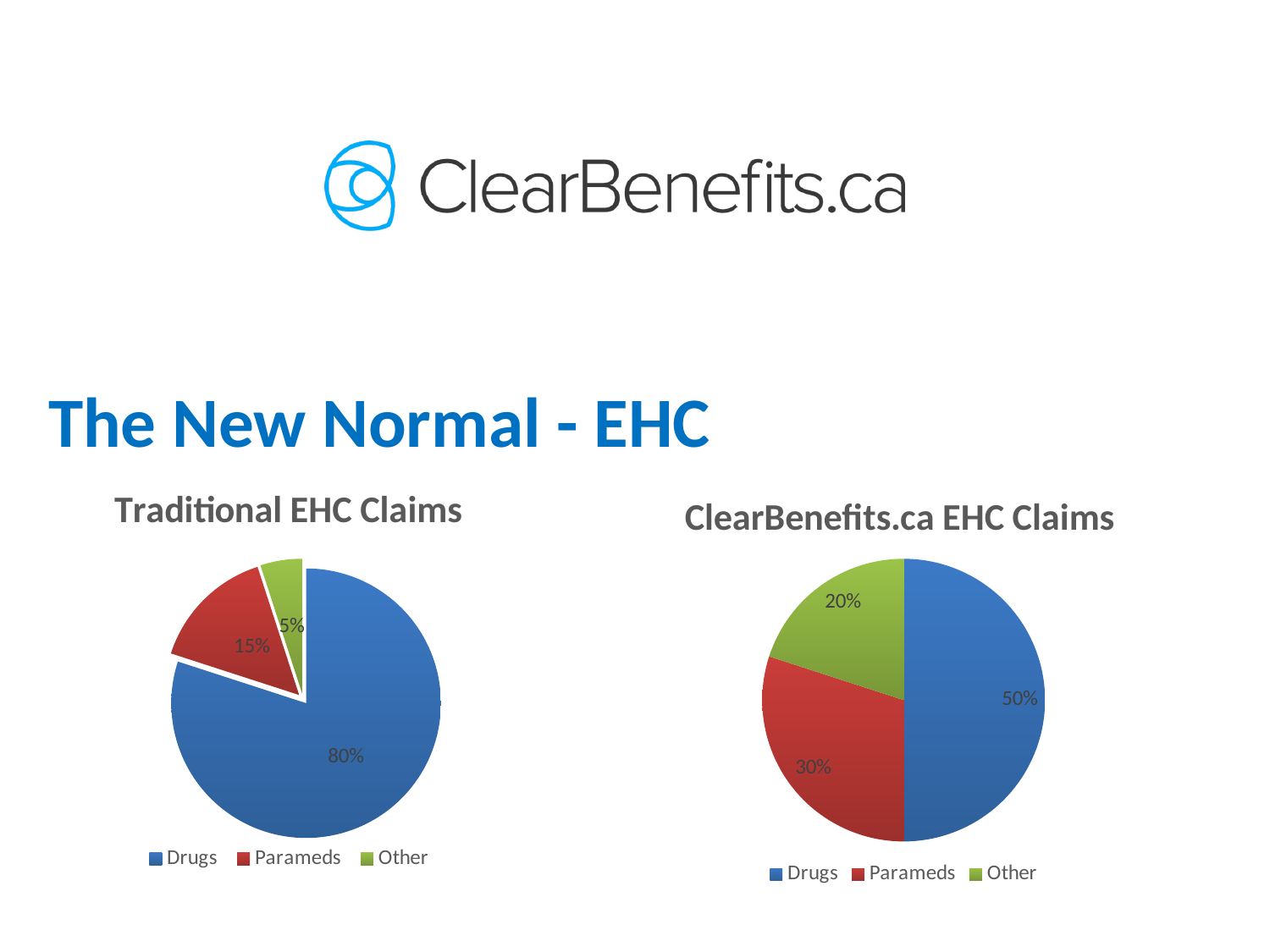
In the ClearBenefits.ca EHC Claims chart, what share of claims is Paramedics? 30% Which chart shows a larger share for Paramedics, Traditional EHC Claims or ClearBenefits.ca EHC Claims? ClearBenefits.ca EHC Claims In the ClearBenefits.ca EHC Claims chart, what share of claims is Other? 20% In the Traditional EHC Claims chart, what share of claims is Paramedics? 15% In the ClearBenefits.ca EHC Claims chart, what is the difference between the Drugs and Paramedics shares? 20% In the ClearBenefits.ca EHC Claims chart, what share of claims is Drugs? 50% How many categories does the legend of the ClearBenefits.ca EHC Claims chart list? 3 In the Traditional EHC Claims chart, what share of claims is Drugs? 80% What type of chart is the Traditional EHC Claims chart? Pie chart In the Traditional EHC Claims chart, which category has the largest slice? Drugs In the Traditional EHC Claims chart, what share of claims is Other? 5% In the ClearBenefits.ca EHC Claims chart, which category has the smallest slice? Other